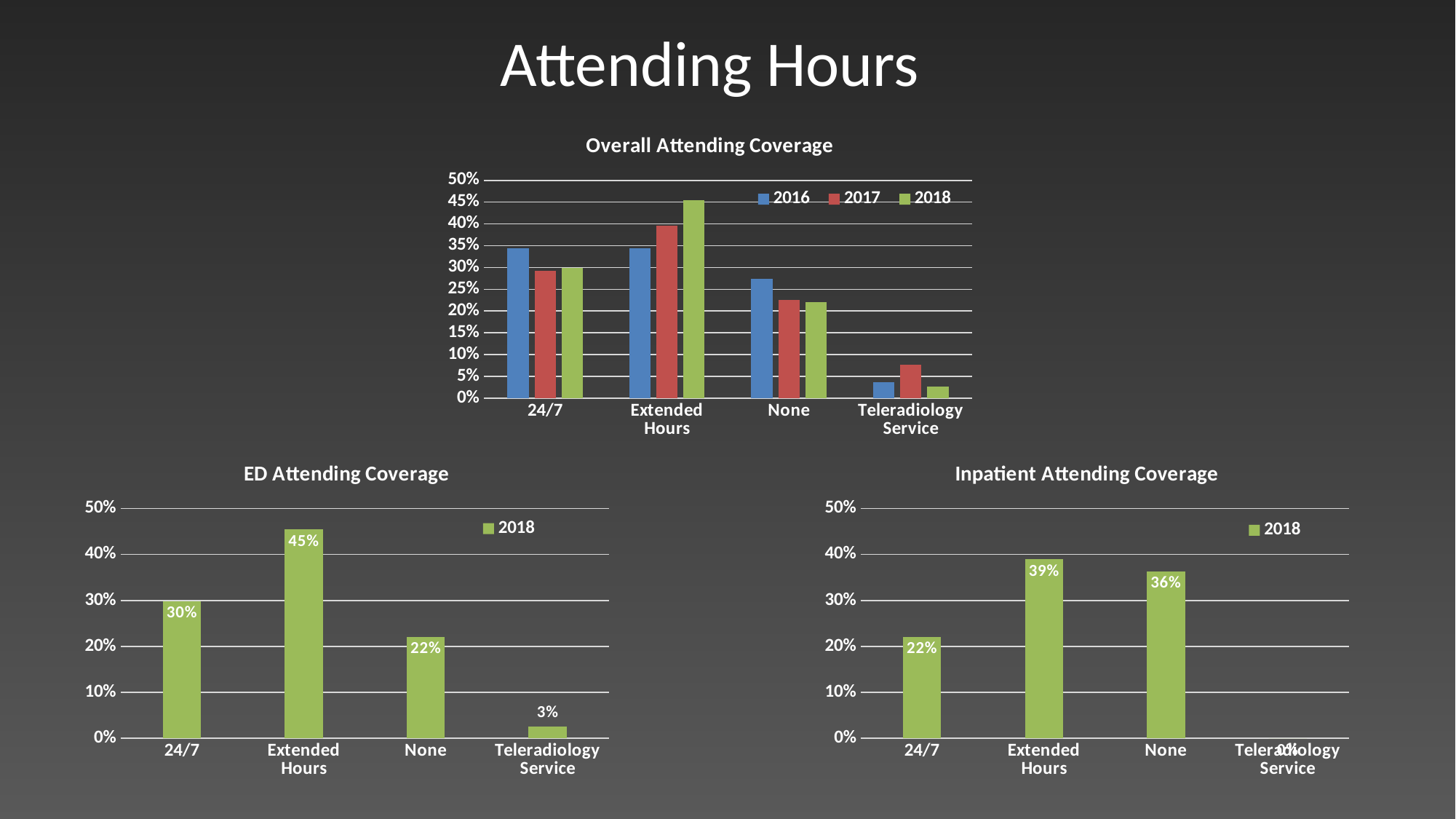
In the ED Attending Coverage chart, which category has the lowest value? Teleradiology Service In the Inpatient Attending Coverage chart, what is the value for 24/7? 22% In the Overall Attending Coverage chart, how many series does the legend list? 3 In the Inpatient Attending Coverage chart, which category has the highest value? Extended Hours In the Overall Attending Coverage chart, which year has the highest value for 24/7? 2016 In the ED Attending Coverage chart, what is the value for None? 22% In the Inpatient Attending Coverage chart, which is larger, the value for None or the value for 24/7? None In the ED Attending Coverage chart, what is the value for Extended Hours? 45% In the ED Attending Coverage chart, what is the difference between the values for Extended Hours and 24/7? 15% What kind of chart is the ED Attending Coverage chart? Bar chart In the Overall Attending Coverage chart, is the 2018 value for Extended Hours greater or less than 40%? greater In the Inpatient Attending Coverage chart, what is the value for Extended Hours? 39%